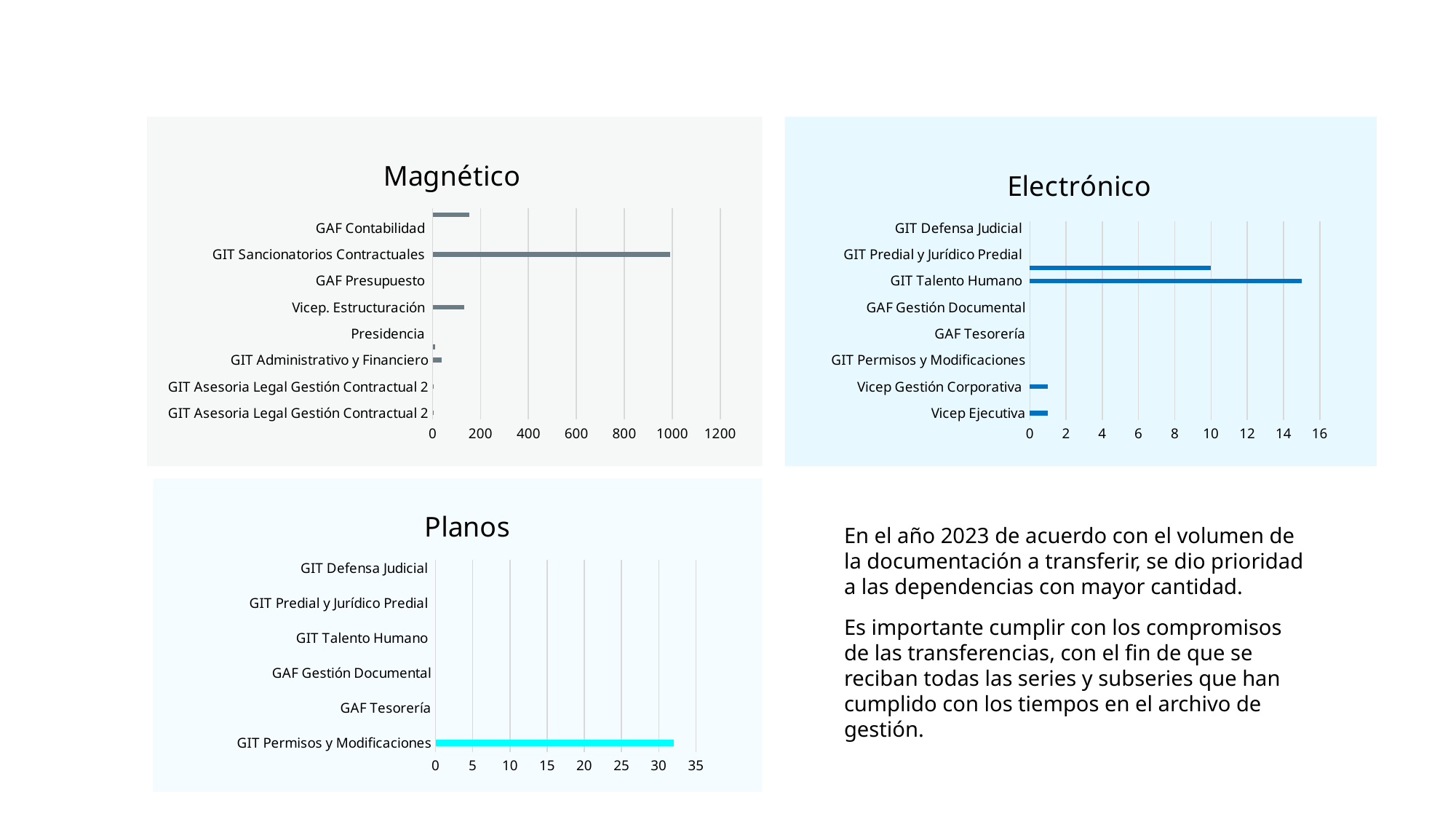
In the Electrónico chart, is the value for GIT Talento Humano greater or less than 14? greater In the Planos chart, which category has the highest value? GIT Permisos y Modificaciones What kind of chart is the Magnético chart? bar chart In the Magnético chart, is the value for GIT Sancionatorios Contractuales greater or less than 800? greater In the Planos chart, is the value for GIT Permisos y Modificaciones greater or less than 30? greater In the Magnético chart, which category has the highest value? GIT Sancionatorios Contractuales In the Electrónico chart, which category has the highest value? GIT Talento Humano